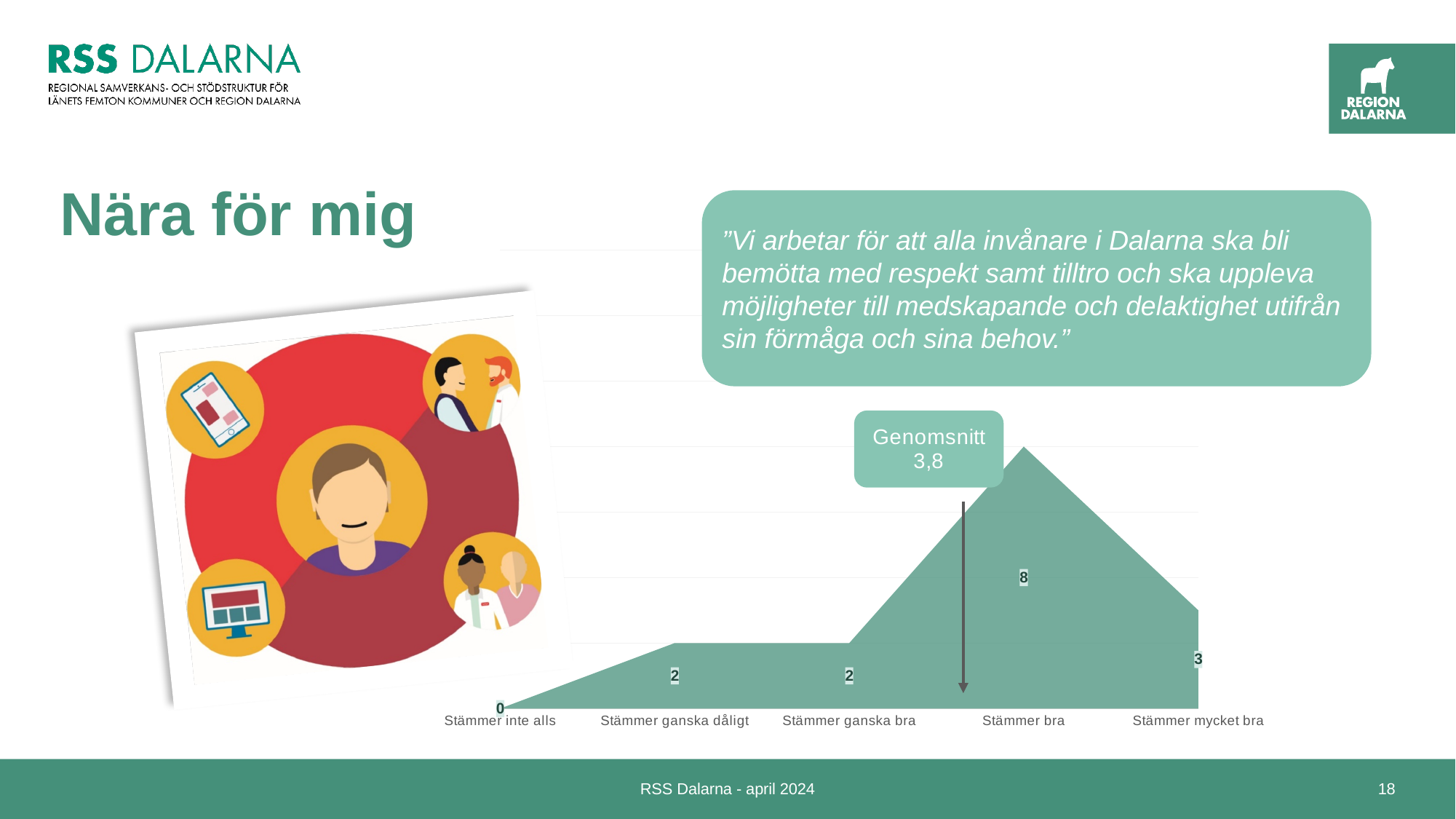
What kind of chart is shown on the slide? Area chart Which category has the lowest value? Stämmer inte alls What is the value for "Stämmer mycket bra"? 3 What is the value for "Stämmer ganska dåligt"? 2 Which category has the highest value? Stämmer bra What is the value for "Stämmer bra"? 8 Which is larger, the value for "Stämmer ganska bra" or the value for "Stämmer mycket bra"? Stämmer mycket bra What is the total of all the values plotted in the chart? 15 What is the value for "Stämmer inte alls"? 0 What is the difference between the values for "Stämmer bra" and "Stämmer mycket bra"? 5 How many categories are shown on the x axis of the chart? 5 What average (Genomsnitt) value is annotated on the chart? 3,8